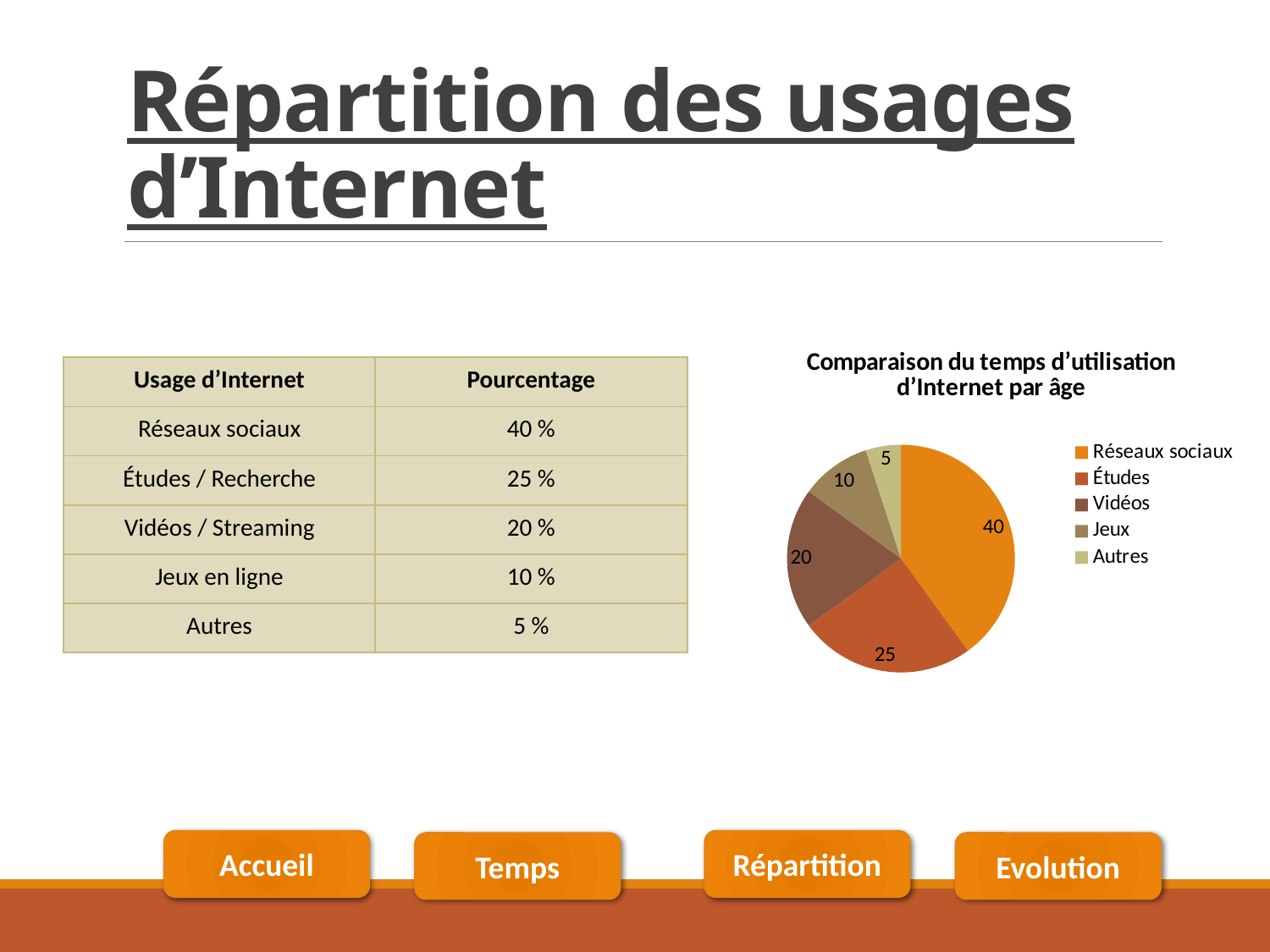
Which slice of the pie chart is the largest? Réseaux sociaux What value is shown for the Jeux slice of the pie chart? 10 How many entries does the pie chart legend list? 5 What is the difference between the Réseaux sociaux and Vidéos values in the pie chart? 20 Which slice of the pie chart is the smallest? Autres What kind of chart is shown on the slide? pie chart How many slices does the pie chart have? 5 What value is shown for the Études slice of the pie chart? 25 What share of the pie does the Vidéos slice represent? 20% What value is shown for the Réseaux sociaux slice of the pie chart? 40 What is the title of the pie chart? Comparaison du temps d'utilisation d'Internet par âge Which is larger in the pie chart, Études or Jeux? Études